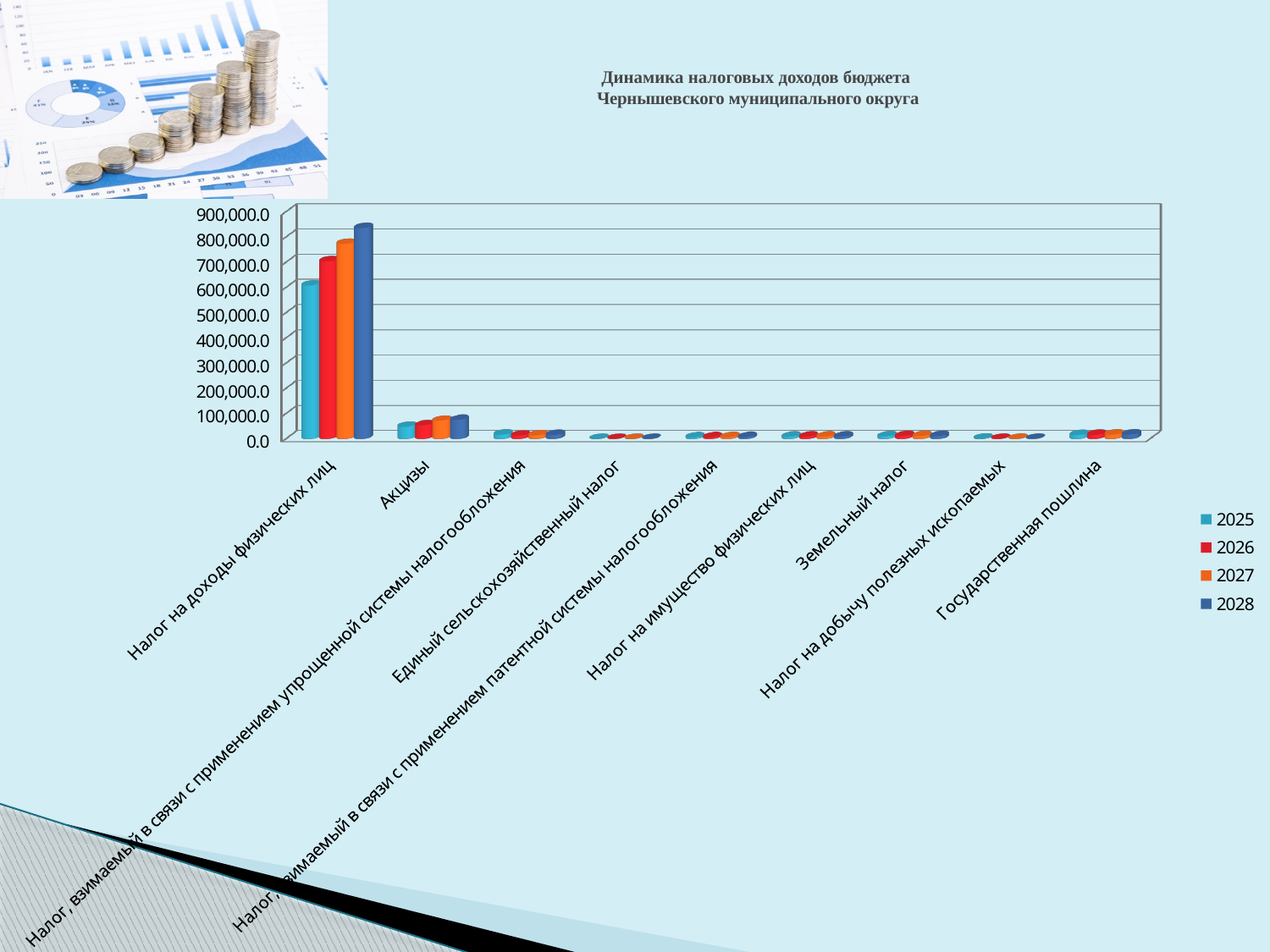
How many categories are shown on the x axis? 9 What kind of chart is shown on the slide? bar chart Which category has the highest values in the chart? Налог на доходы физических лиц Is the 2028 value for Акцизы greater or less than 100,000.0? less For Налог на доходы физических лиц, do the values rise or fall from 2025 to 2028? rise In 2028, which is larger: Акцизы or Земельный налог? Акцизы Is the 2025 value for Налог на доходы физических лиц greater or less than 500,000.0? greater How many series does the legend list? 4 Is the 2028 value for Налог на доходы физических лиц greater or less than 700,000.0? greater For Налог на доходы физических лиц, which is larger: the 2025 value or the 2028 value? 2028 What is the title of the chart? Динамика налоговых доходов бюджета Чернышевского муниципального округа